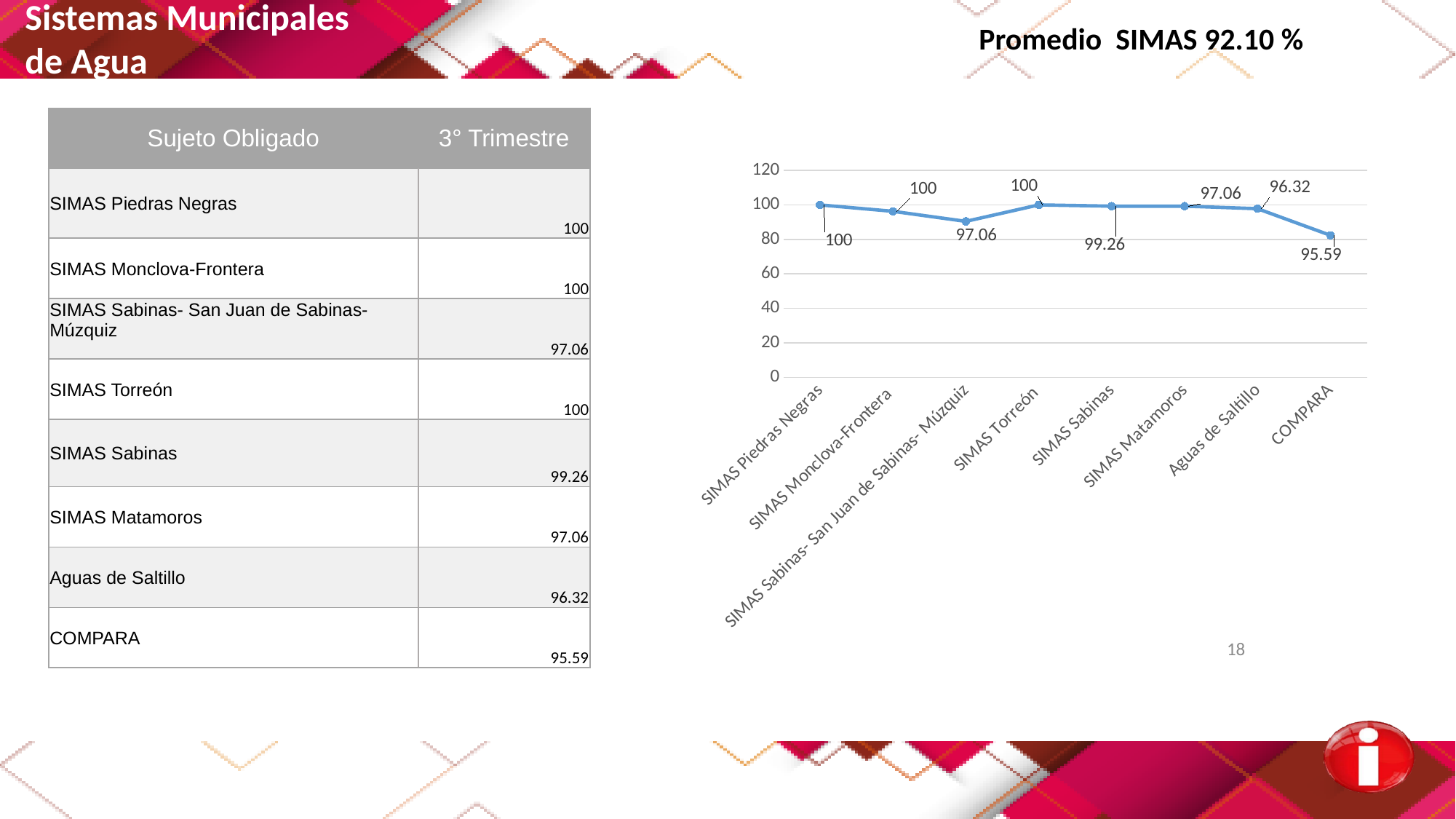
What is the value for Aguas de Saltillo in the chart? 96.32 Which is larger, the value for SIMAS Sabinas or the value for Aguas de Saltillo? SIMAS Sabinas What is the value for SIMAS Piedras Negras in the chart? 100 What is the value for SIMAS Matamoros in the chart? 97.06 What is the value for SIMAS Sabinas in the chart? 99.26 What is the highest tick value shown on the y axis of the chart? 120 Which category has the lowest value in the chart? COMPARA What is the value for COMPARA in the chart? 95.59 Is the value for COMPARA greater or less than 100? less How many categories are plotted on the x axis of the chart? 8 What is the difference between the values for SIMAS Piedras Negras and COMPARA? 4.41 What type of chart is shown on the slide? line chart